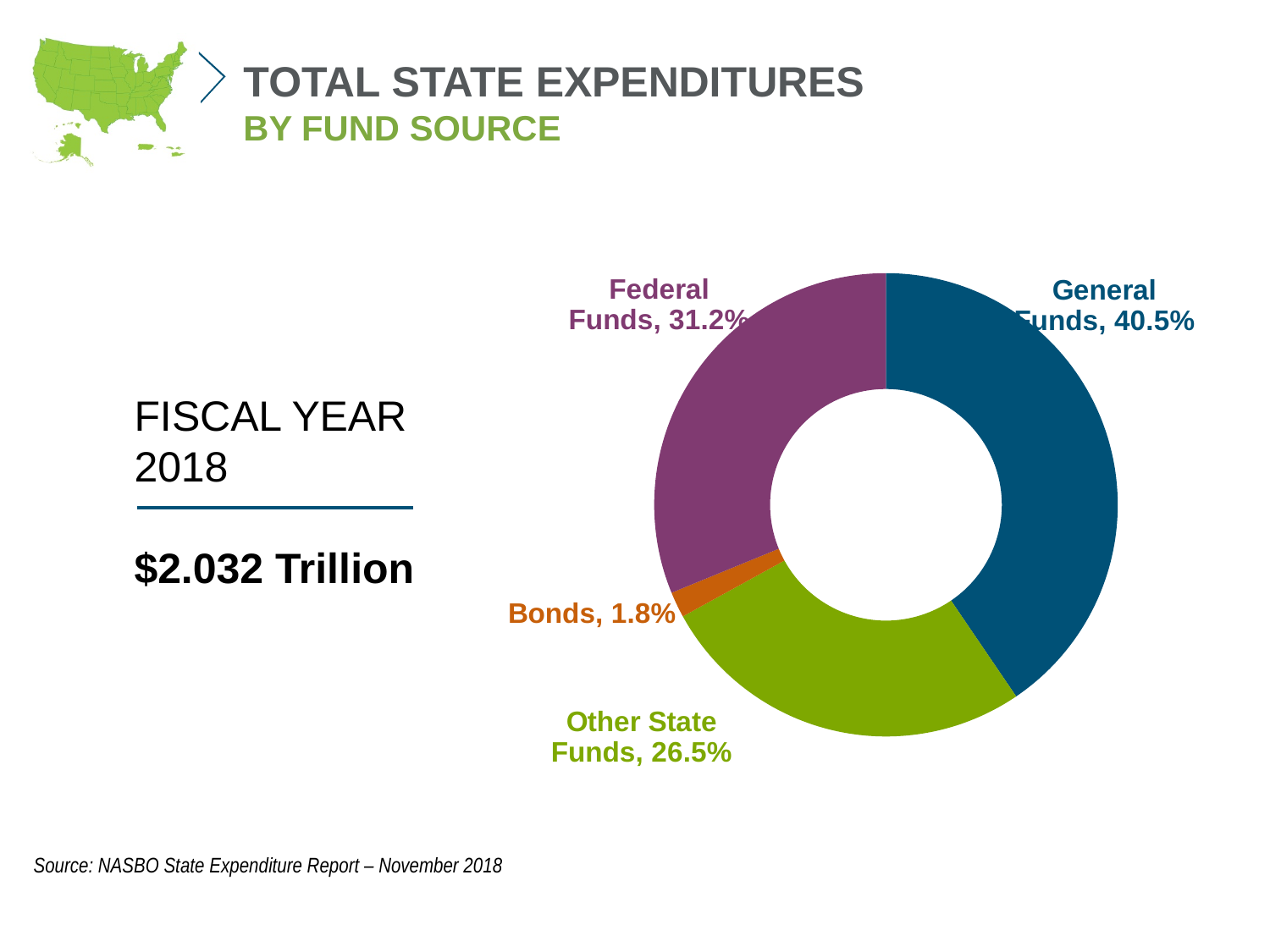
What total dollar amount of state expenditures does the slide give for fiscal year 2018? $2.032 Trillion Which fund source has the largest share of total state expenditures? General Funds What share of total state expenditures comes from Other State Funds? 26.5% How many fund sources are shown in the chart? 4 How many percentage points larger is the General Funds share than the Federal Funds share? 9.3 How many percentage points larger is the Federal Funds share than the Other State Funds share? 4.7 What kind of chart is shown on the slide? Pie chart (doughnut) Which is larger, the share for Federal Funds or the share for Other State Funds? Federal Funds What share of total state expenditures comes from Bonds? 1.8% Which fund source has the smallest share of total state expenditures? Bonds What share of total state expenditures comes from Federal Funds? 31.2% What share of total state expenditures comes from General Funds? 40.5%